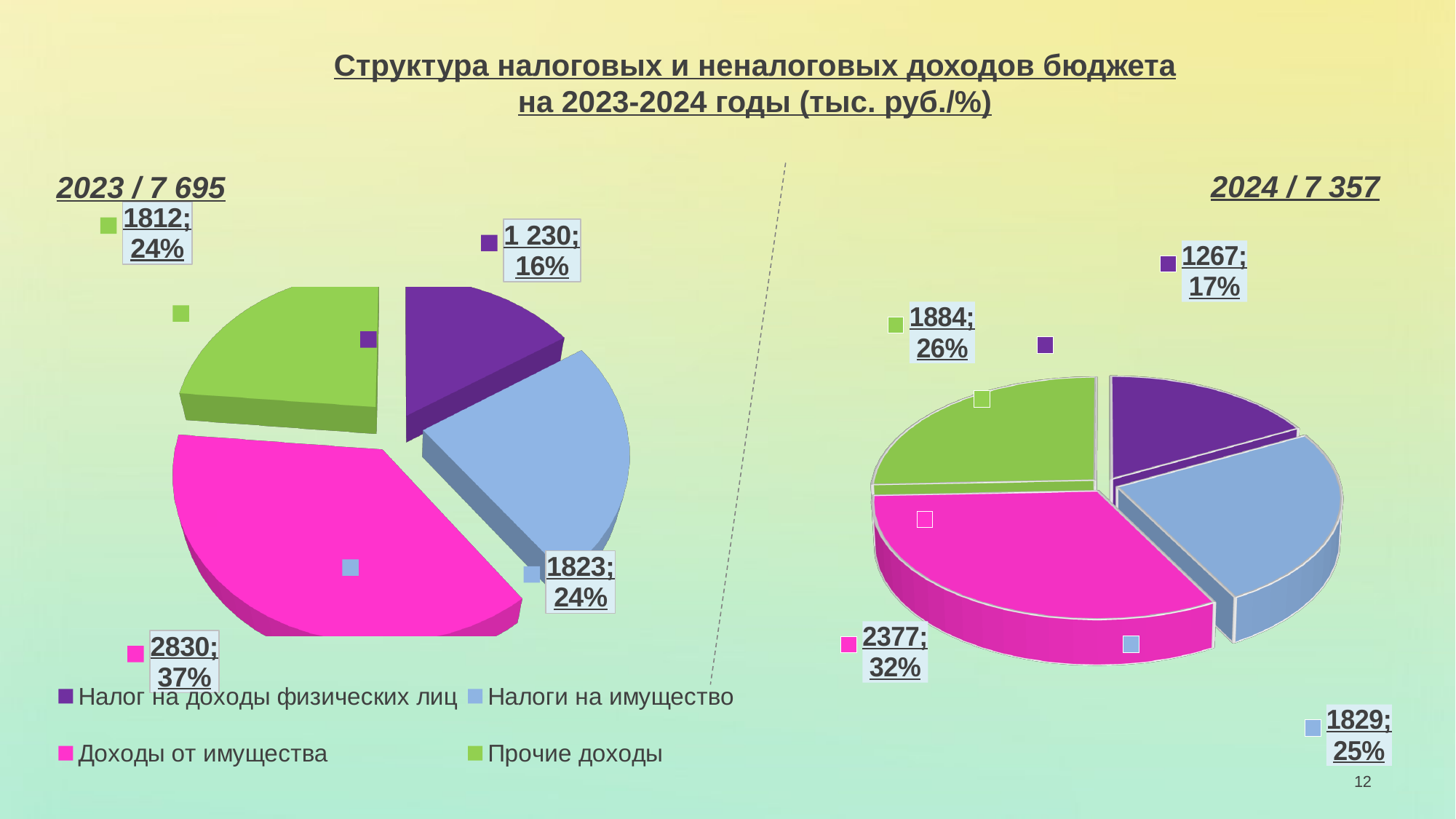
In the 2023 pie chart, which category has the largest slice? Доходы от имущества In the 2023 pie chart, which is larger: Налоги на имущество or Налог на доходы физических лиц? Налоги на имущество What total is shown in the heading of the 2024 chart? 7 357 How many slices does the 2024 pie chart have? 4 In the 2024 pie chart, what is the difference between the values for Доходы от имущества and Налоги на имущество? 548 In the 2023 pie chart, what is the value shown for Доходы от имущества? 2830; 37% In the 2024 pie chart, what is the value shown for Налог на доходы физических лиц? 1267; 17% In the 2024 pie chart, which category has the smallest slice? Налог на доходы физических лиц In the 2024 pie chart, what value is shown for Прочие доходы? 1884; 26% In the 2023 pie chart, what percentage is shown for Налоги на имущество? 24% What type of chart is used on the left side of the slide for 2023? Pie chart How many entries does the legend list? 4